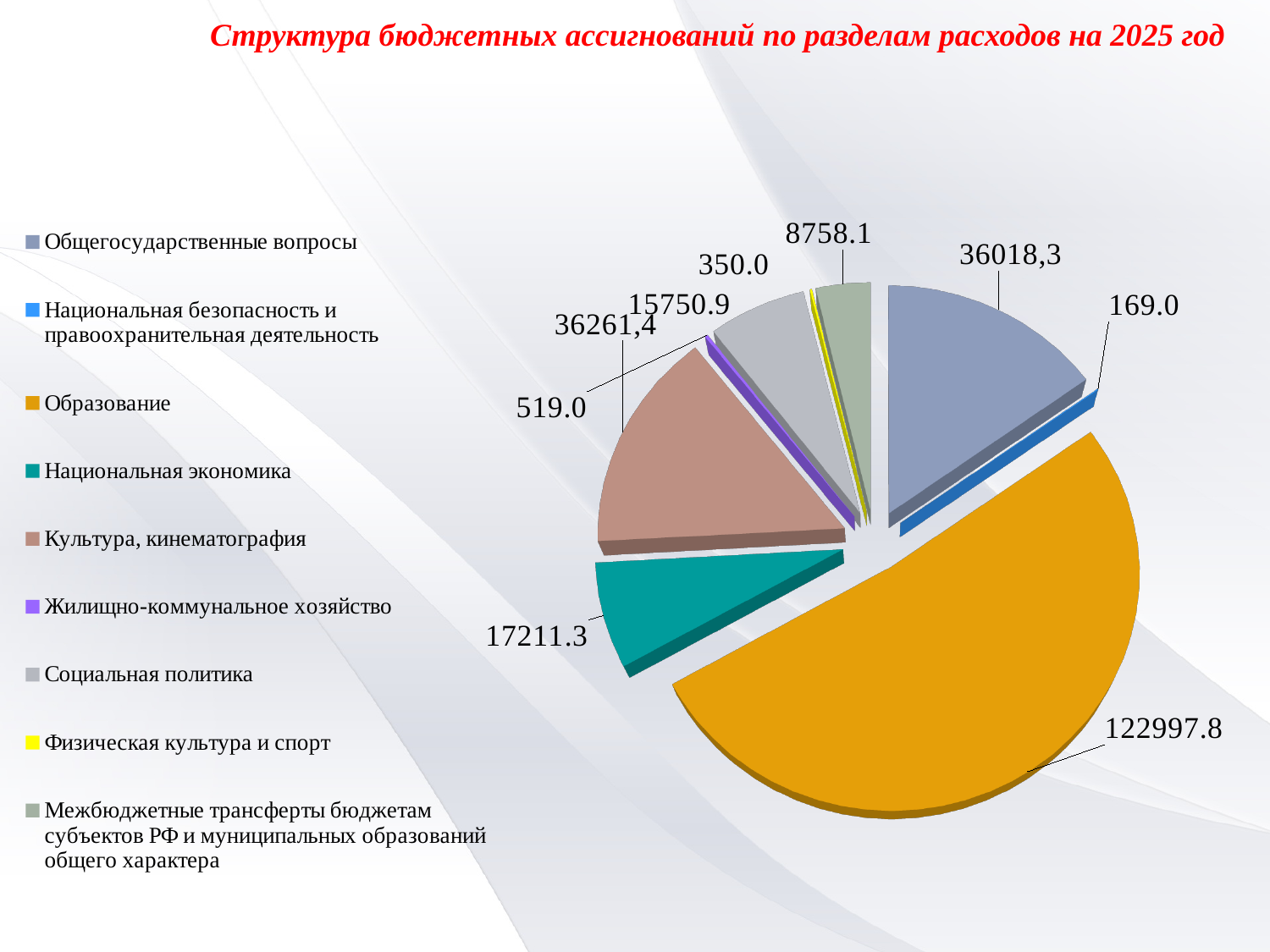
What is the value for Национальная экономика? 17211.3 What is the value for Общегосударственные вопросы? 36018,3 Which category has the largest slice? Образование What is the title of the chart? Структура бюджетных ассигнований по разделам расходов на 2025 год What is the difference between the values for Национальная экономика and Социальная политика? 1460.4 What is the value for Межбюджетные трансферты бюджетам субъектов РФ и муниципальных образований общего характера? 8758.1 How many categories does the pie chart have? 9 What is the value for Образование? 122997.8 What kind of chart is shown on the slide? Pie chart Which category has the smallest value? Национальная безопасность и правоохранительная деятельность Which is larger, the value for Жилищно-коммунальное хозяйство or the value for Физическая культура и спорт? Жилищно-коммунальное хозяйство What is the value for Социальная политика? 15750.9